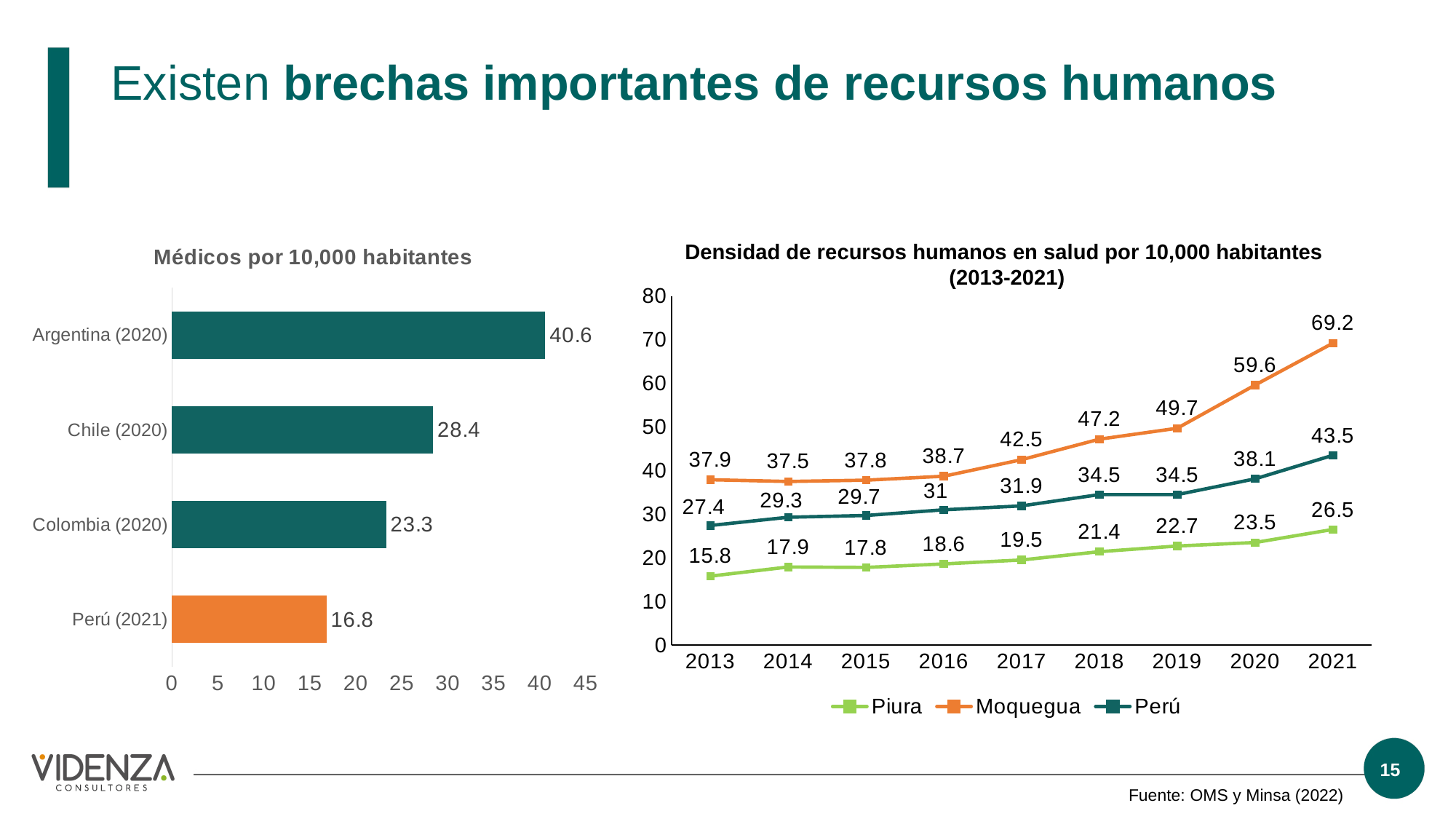
In the 'Densidad de recursos humanos en salud por 10,000 habitantes (2013-2021)' chart, which is larger in 2019: Perú or Piura? Perú In the 'Densidad de recursos humanos en salud por 10,000 habitantes (2013-2021)' chart, does the Moquegua series rise or fall from 2016 to 2021? Rise In the 'Densidad de recursos humanos en salud por 10,000 habitantes (2013-2021)' chart, what is the difference between Moquegua and Perú in 2021? 25.7 In the 'Médicos por 10,000 habitantes' chart, what is the value for Chile (2020)? 28.4 In the 'Densidad de recursos humanos en salud por 10,000 habitantes (2013-2021)' chart, what is the value for Moquegua in 2021? 69.2 In the 'Densidad de recursos humanos en salud por 10,000 habitantes (2013-2021)' chart, what is the value for Piura in 2013? 15.8 In the 'Densidad de recursos humanos en salud por 10,000 habitantes (2013-2021)' chart, how many series does the legend list? 3 What kind of chart is 'Médicos por 10,000 habitantes'? Bar chart In the 'Médicos por 10,000 habitantes' chart, which country has the highest value? Argentina (2020) In the 'Médicos por 10,000 habitantes' chart, which country has the lowest value? Perú (2021) In the 'Médicos por 10,000 habitantes' chart, what is the difference between Argentina (2020) and Perú (2021)? 23.8 In the 'Médicos por 10,000 habitantes' chart, how many countries are shown? 4